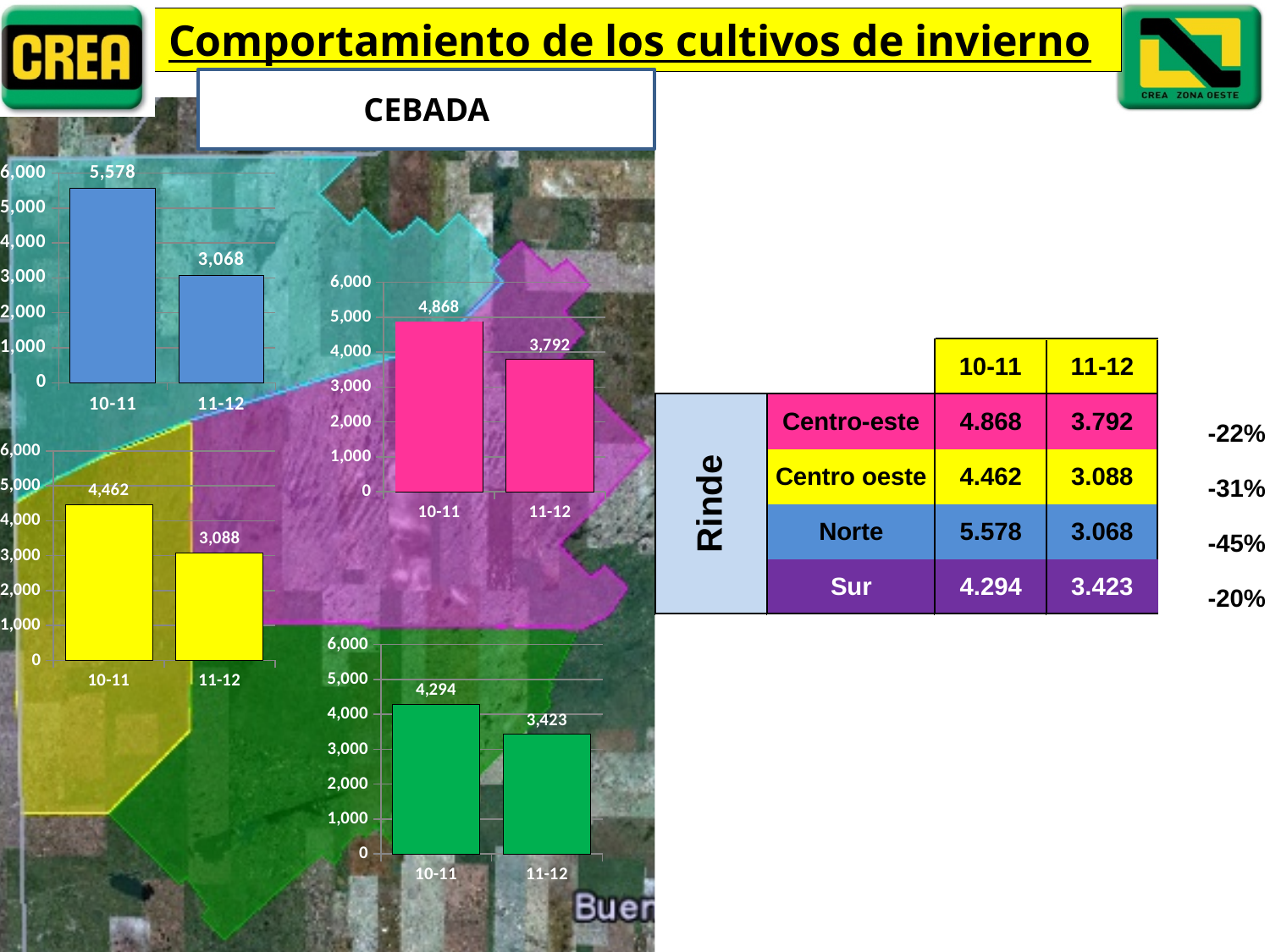
In the green bar chart at the bottom of the slide, what is the value for 11-12? 3,423 In the green bar chart at the bottom of the slide, is the value for 10-11 greater or less than 4,000? greater In the blue bar chart at the top left of the slide, what is the value for 10-11? 5,578 In the blue bar chart at the top left of the slide, what is the value for 11-12? 3,068 In the pink bar chart in the centre of the slide, what is the value for 11-12? 3,792 In the blue bar chart at the top left of the slide, what is the difference between the 10-11 and 11-12 values? 2,510 In the pink bar chart in the centre of the slide, what is the difference between the 10-11 and 11-12 values? 1,076 In the green bar chart at the bottom of the slide, which category has the higher value, 10-11 or 11-12? 10-11 In the yellow bar chart on the left of the slide, what is the value for 10-11? 4,462 In the yellow bar chart on the left of the slide, do the values rise or fall from 10-11 to 11-12? fall What kind of chart is the blue chart at the top left of the slide? bar chart How many bars does the pink bar chart in the centre of the slide have? 2